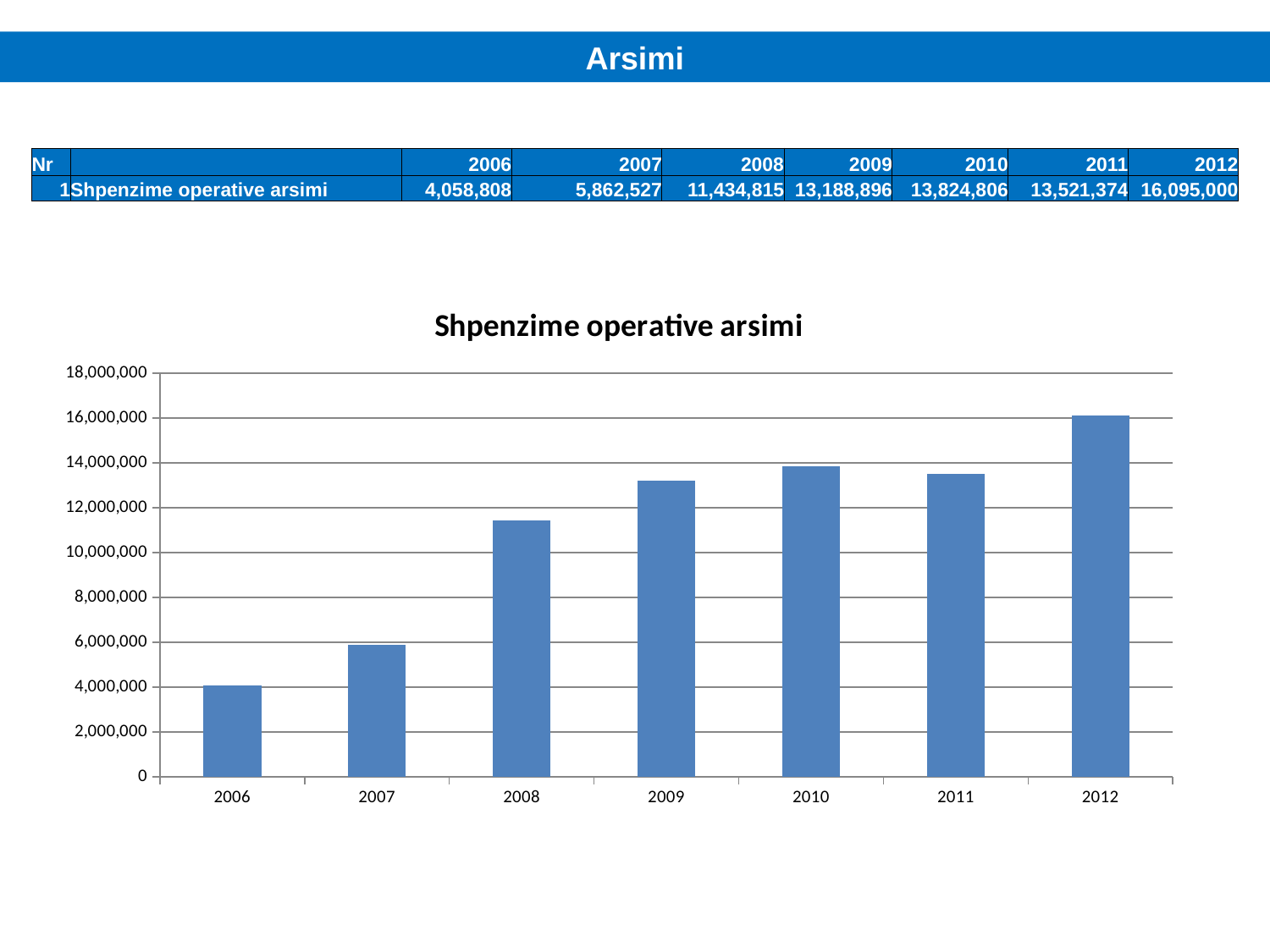
What is the value for 2009 in the Shpenzime operative arsimi chart? 13,188,896 What is the title of the chart on the slide? Shpenzime operative arsimi Which year has the highest value in the Shpenzime operative arsimi chart? 2012 What kind of chart is the Shpenzime operative arsimi chart? bar chart What is the value for 2012 in the Shpenzime operative arsimi chart? 16,095,000 How many years are shown on the x axis of the Shpenzime operative arsimi chart? 7 Which is larger in the Shpenzime operative arsimi chart, the value for 2010 or the value for 2011? 2010 Is the value for 2008 in the Shpenzime operative arsimi chart greater or less than 10,000,000? greater What is the difference between the values for 2012 and 2006 in the Shpenzime operative arsimi chart? 12,036,192 What is the value for 2006 in the Shpenzime operative arsimi chart? 4,058,808 What is the difference between the values for 2008 and 2007 in the Shpenzime operative arsimi chart? 5,572,288 Which year has the lowest value in the Shpenzime operative arsimi chart? 2006